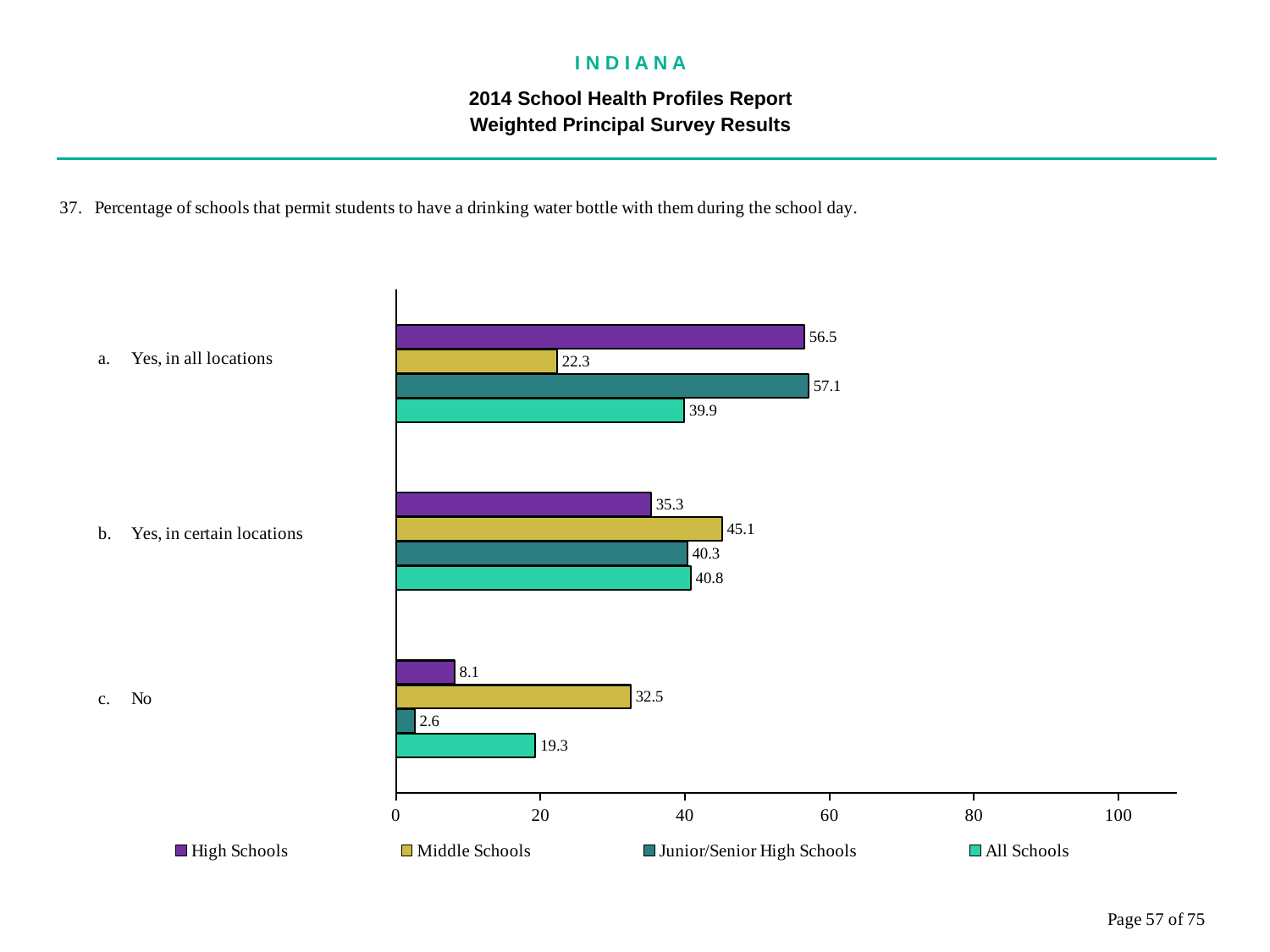
Which series is shown in purple in the legend? High Schools Is the value for All Schools in the 'No' category greater or less than 20? less How many series does the legend list? 4 What is the value for All Schools in the 'Yes, in certain locations' category? 40.8 Which category has the lowest value for Junior/Senior High Schools? No What is the difference between the Middle Schools and High Schools values in the 'No' category? 24.4 In the 'Yes, in all locations' category, which is larger: the value for High Schools or the value for Middle Schools? High Schools What kind of chart is shown on the slide? bar chart What is the value for High Schools in the 'Yes, in all locations' category? 56.5 What is the value for Middle Schools in the 'No' category? 32.5 How many categories are shown on the chart? 3 Which category has the highest value for Middle Schools? Yes, in certain locations